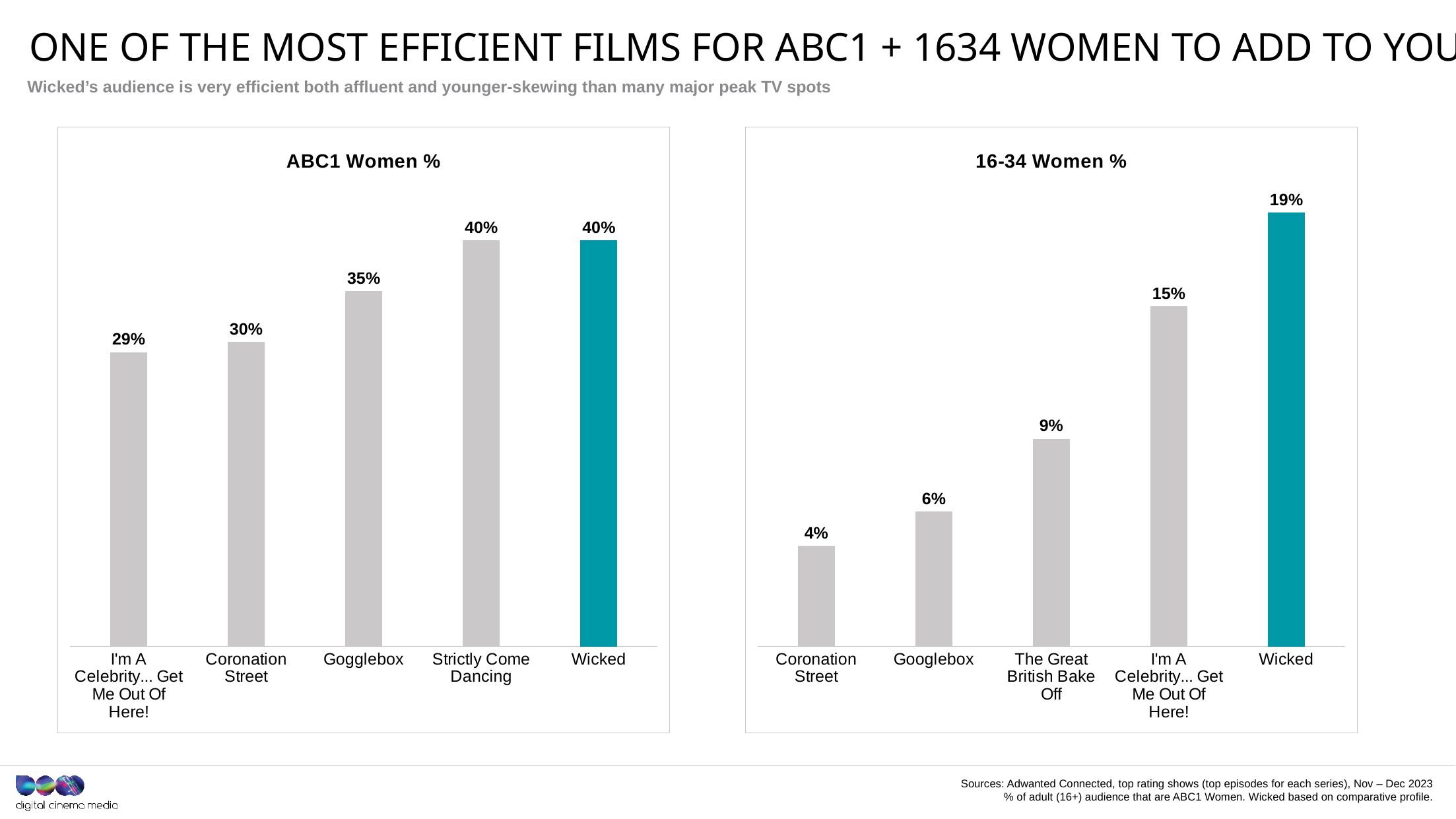
In the 'ABC1 Women %' chart, what is the value for Coronation Street? 30% In the '16-34 Women %' chart, which is larger, Googlebox or The Great British Bake Off? The Great British Bake Off In the '16-34 Women %' chart, what is the value for The Great British Bake Off? 9% In the 'ABC1 Women %' chart, how many categories are shown? 5 In the '16-34 Women %' chart, what is the value for Wicked? 19% In the '16-34 Women %' chart, which category has the lowest value? Coronation Street In the 'ABC1 Women %' chart, what is the value for Gogglebox? 35% In the '16-34 Women %' chart, which category has the highest value? Wicked What type of chart is the '16-34 Women %' chart? Bar chart In the 'ABC1 Women %' chart, what is the difference between Wicked and I'm A Celebrity... Get Me Out Of Here!? 11% In the '16-34 Women %' chart, what is the difference between Wicked and I'm A Celebrity... Get Me Out Of Here!? 4% In the 'ABC1 Women %' chart, which category has the lowest value? I'm A Celebrity... Get Me Out Of Here!